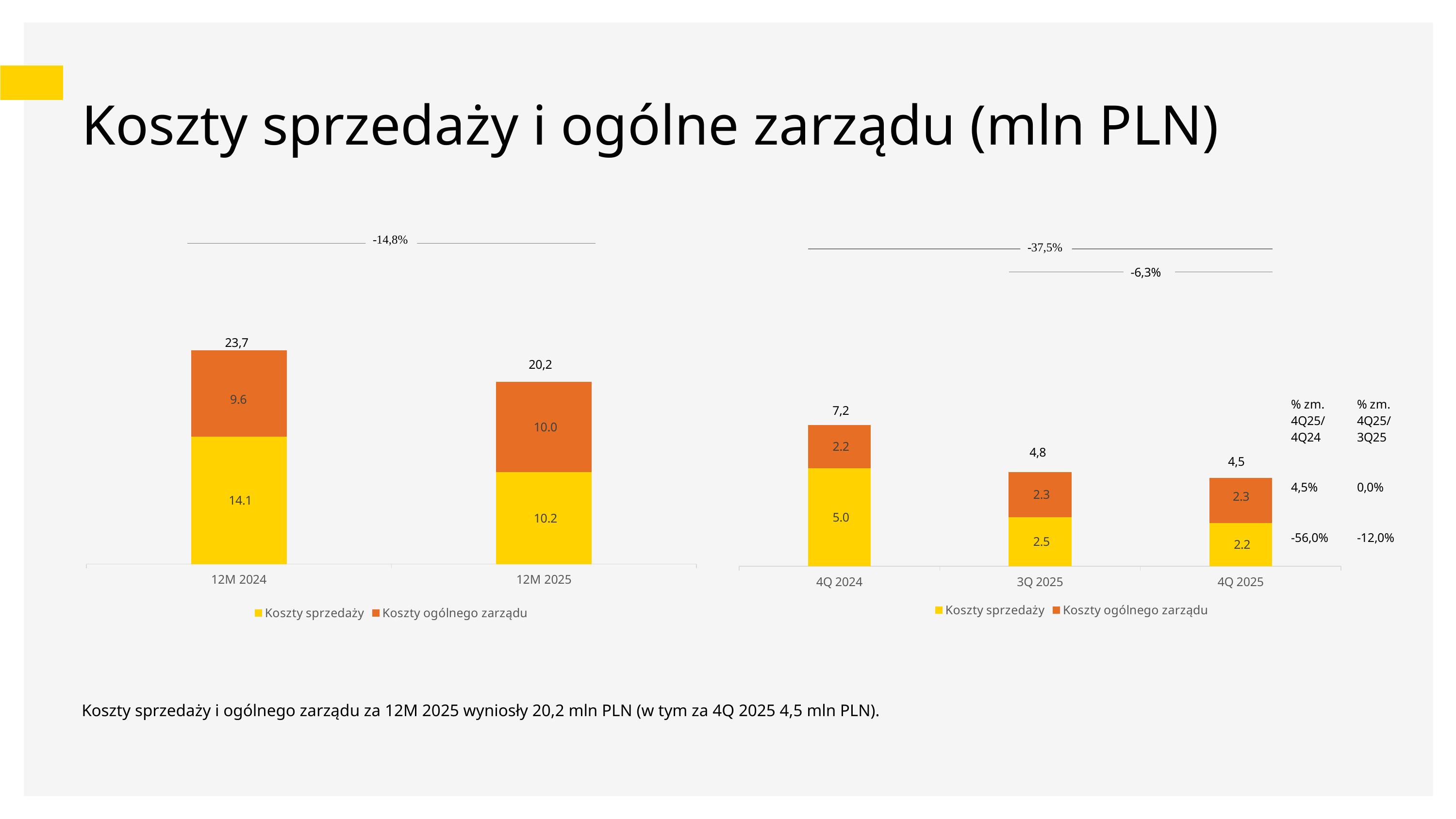
On the right chart, what is the total of the stacked bar for 4Q 2025? 4,5 On the right chart, which quarter has the highest total? 4Q 2024 What kind of chart is the left chart? Stacked bar chart On the right chart, how many quarters are shown on the x axis? 3 On the right chart, what is the value of Koszty sprzedaży for 4Q 2024? 5.0 On the left chart, what is the value of Koszty sprzedaży for 12M 2024? 14.1 On the left chart, what percentage change is shown between 12M 2024 and 12M 2025? -14,8% On the left chart, what is the difference between Koszty sprzedaży for 12M 2024 and 12M 2025? 3.9 On the right chart, how many series does the legend list? 2 On the left chart, what is the value of Koszty ogólnego zarządu for 12M 2025? 10.0 On the left chart, what is the total of the stacked bar for 12M 2025? 20,2 On the right chart, what is the value of Koszty ogólnego zarządu for 3Q 2025? 2.3